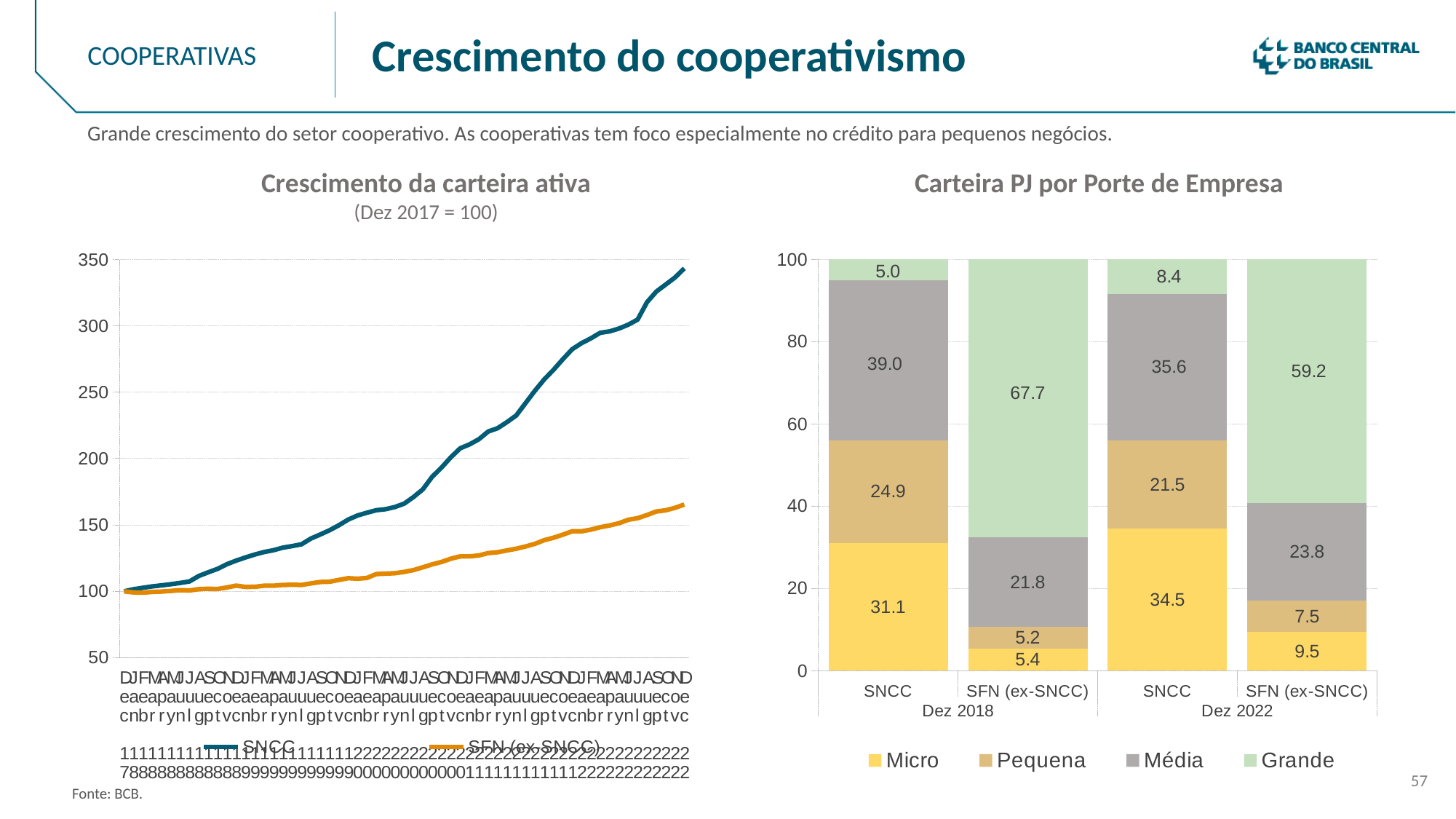
In the chart 'Carteira PJ por Porte de Empresa', what is the value for Micro in the SNCC bar for Dez 2018? 31.1 In the chart 'Crescimento da carteira ativa', does the SFN (ex-SNCC) line rise or fall over time? Rise How many series does the legend of the chart 'Crescimento da carteira ativa' list? 2 In the chart 'Carteira PJ por Porte de Empresa', what is the value for Média in the SNCC bar for Dez 2022? 35.6 In the chart 'Carteira PJ por Porte de Empresa', what is the value for Pequena in the SFN (ex-SNCC) bar for Dez 2018? 5.2 In the chart 'Carteira PJ por Porte de Empresa', what is the difference between the Micro value for SNCC in Dez 2022 and in Dez 2018? 3.4 In the chart 'Carteira PJ por Porte de Empresa', which bar has the highest Grande value? SFN (ex-SNCC), Dez 2018 In the chart 'Carteira PJ por Porte de Empresa', what is the value for Grande in the SFN (ex-SNCC) bar for Dez 2022? 59.2 How many series does the legend of the chart 'Carteira PJ por Porte de Empresa' list? 4 In the chart 'Crescimento da carteira ativa', is the SNCC line at its last point greater or less than 300? greater What kind of chart is 'Carteira PJ por Porte de Empresa'? Stacked bar chart In the chart 'Carteira PJ por Porte de Empresa', is the Pequena value larger for SNCC or for SFN (ex-SNCC) in Dez 2022? SNCC